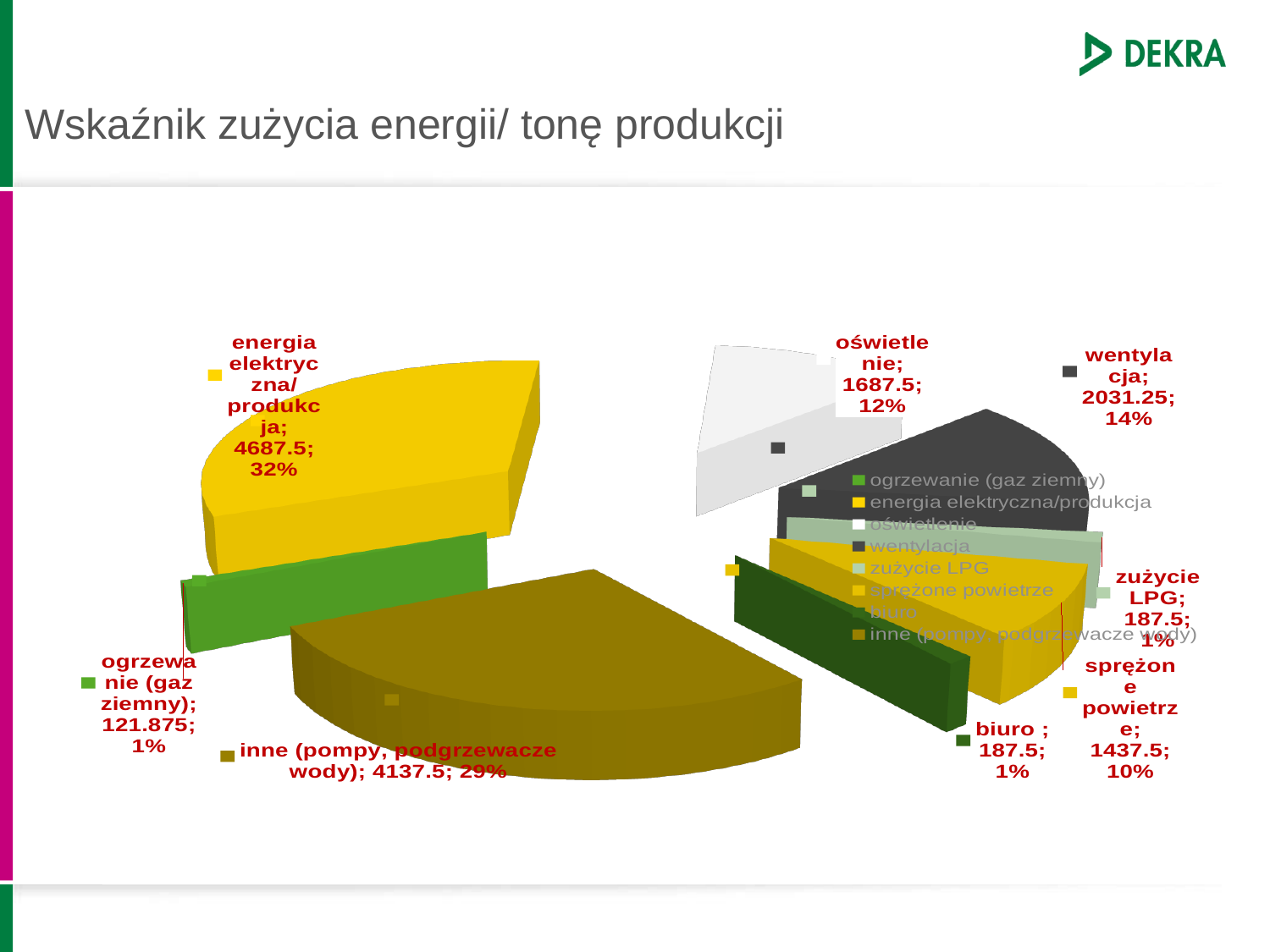
Which category has the smallest value? ogrzewanie (gaz ziemny) What is the difference between the values for energia elektryczna/produkcja and inne (pompy, podgrzewacze wody)? 550 What is the value for ogrzewanie (gaz ziemny)? 121.875 What is the value for energia elektryczna/produkcja? 4687.5 What is the value for wentylacja? 2031.25 Which is larger, wentylacja or oświetlenie? wentylacja What is the value for oświetlenie? 1687.5 Which category has the largest slice? energia elektryczna/produkcja What percentage share does inne (pompy, podgrzewacze wody) have? 29% How many categories does the legend list? 8 What kind of chart is shown on the slide? pie chart What percentage share does sprężone powietrze have? 10%